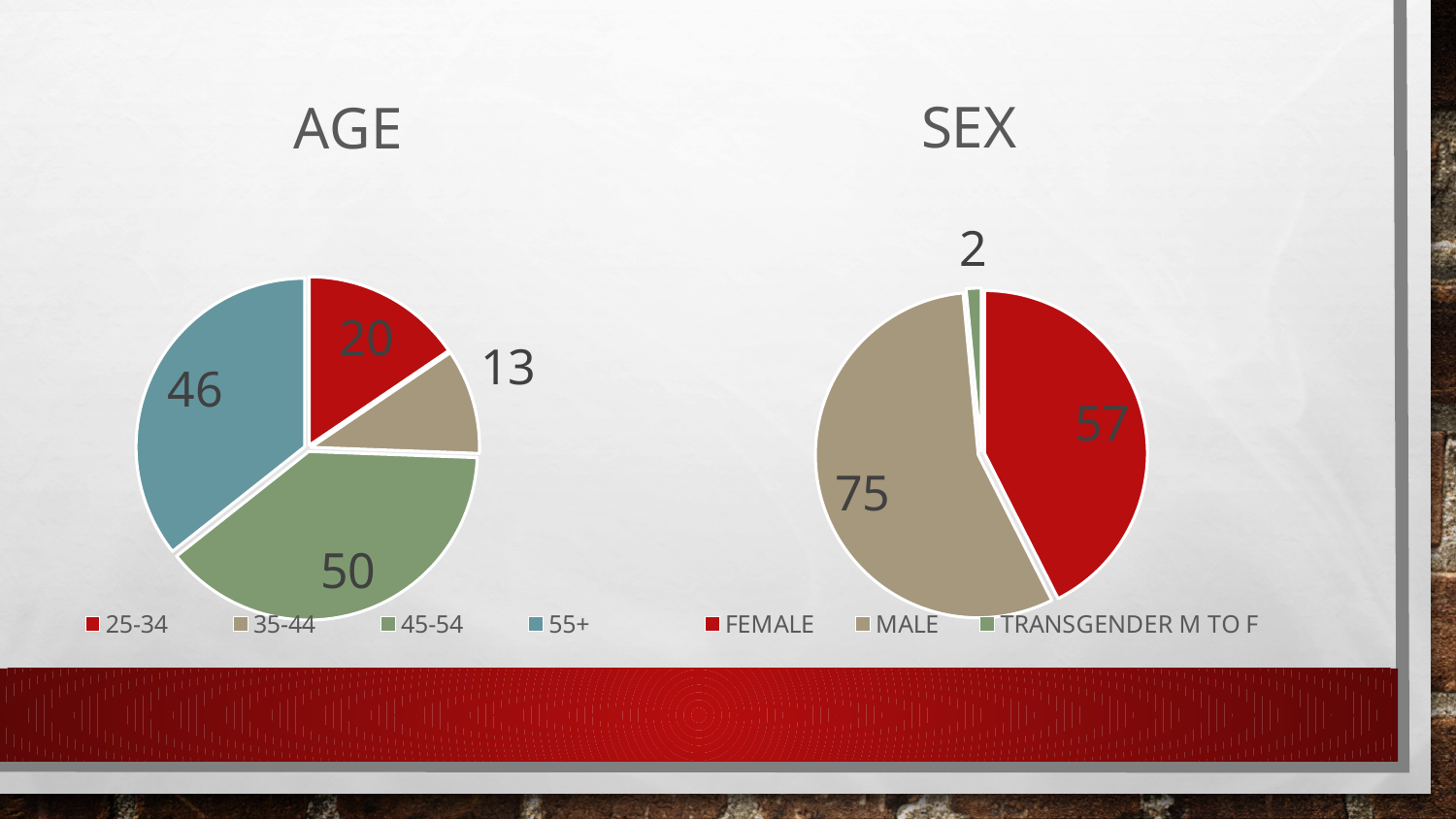
What kind of chart is the SEX chart? Pie chart In the AGE chart, what is the difference between the 45-54 and 25-34 values? 30 In the AGE chart, which is larger, the value for 25-34 or the value for 35-44? 25-34 In the SEX chart, what colour is the FEMALE slice? Red In the SEX chart, what is the difference between the MALE and FEMALE values? 18 In the SEX chart, what is the value for TRANSGENDER M TO F? 2 In the SEX chart, what is the value for MALE? 75 In the SEX chart, which category has the largest value? MALE In the AGE chart, what is the value for the 55+ category? 46 How many categories does the AGE chart show? 4 In the AGE chart, what is the value for the 45-54 category? 50 In the AGE chart, which category has the smallest value? 35-44